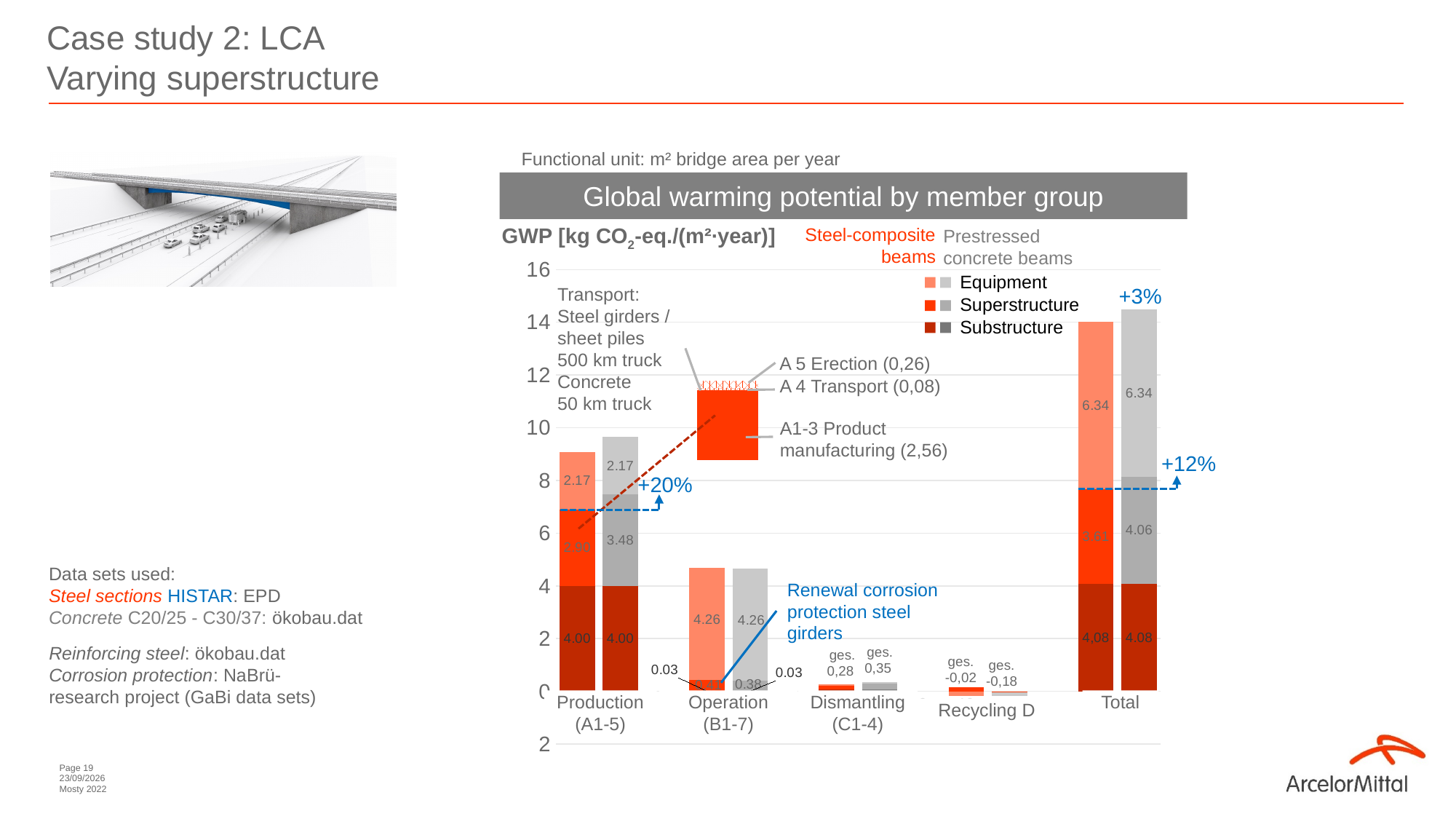
What is the total of the stacked Production (A1-5) bar for prestressed concrete beams? 9.65 How many series does the legend of the chart list? 3 What percentage difference is annotated above the Total bars? +3% What is the Superstructure value in the Total bar for prestressed concrete beams? 4.06 What kind of chart is shown under the title 'Global warming potential by member group'? Stacked bar chart What is the Superstructure value for Production (A1-5) for prestressed concrete beams? 3.48 What is the Equipment value for Operation (B1-7) for steel-composite beams? 4.26 How many categories are shown along the x axis of the chart? 5 What is the Substructure value for Production (A1-5) for steel-composite beams? 4.00 Which has the larger Superstructure value in the Total bar: steel-composite beams or prestressed concrete beams? Prestressed concrete beams What is the labelled value for Dismantling (C1-4) for prestressed concrete beams? 0,35 What is the labelled value for Recycling D for steel-composite beams? -0,02